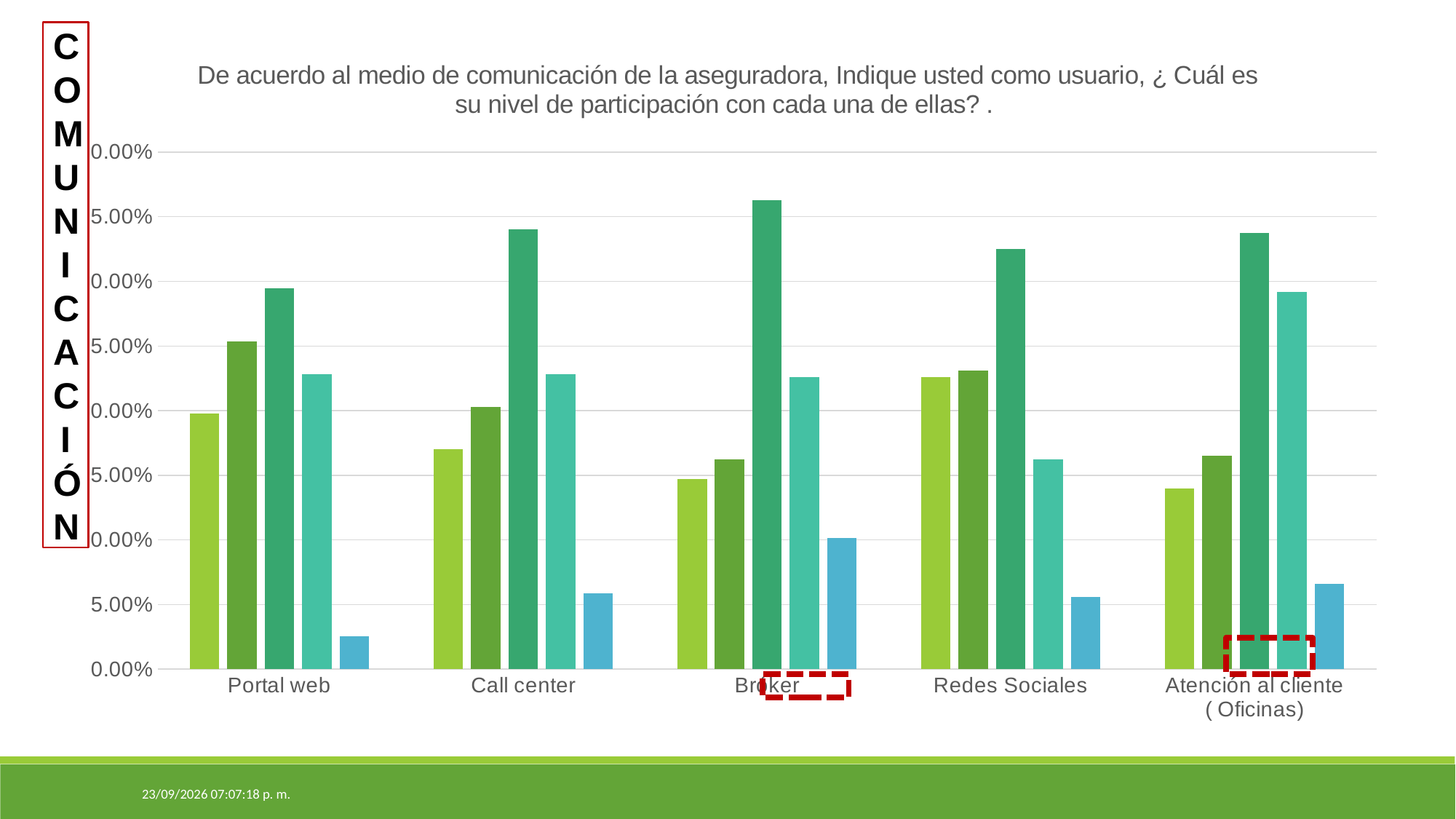
Is the value of the third (dark green) bar for Call center greater or less than 30.00%? greater Which category contains the shortest bar in the chart? Portal web Is the value of the first (light green) bar for Redes Sociales greater or less than 20.00%? greater What is the label of the last category on the x axis? Atención al cliente ( Oficinas) Which category contains the tallest bar in the chart? Broker What kind of chart is shown on the slide? bar chart Is the value of the last (blue) bar for Portal web greater or less than 5.00%? less Which is larger: the first (light green) bar for Redes Sociales or the first (light green) bar for Atención al cliente (Oficinas)? Redes Sociales How many communication channels (categories) are shown on the x axis? 5 Which is larger: the first (light green) bar for Portal web or the first (light green) bar for Call center? Portal web